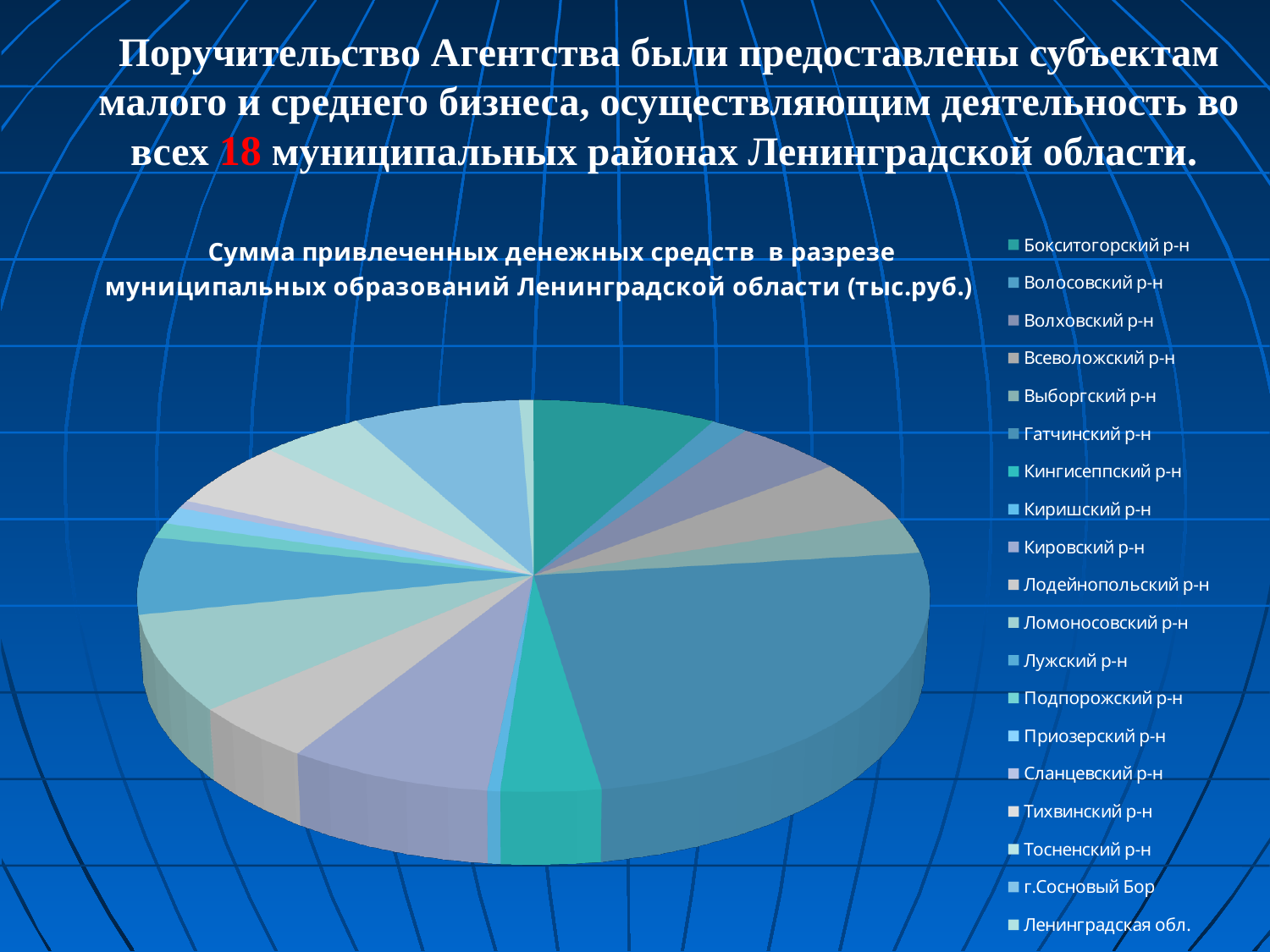
Which category has the largest slice in the pie chart? Гатчинский р-н What kind of chart is shown on the slide? pie chart Is the slice for Кингисеппский р-н larger or smaller than the slice for Киришский р-н? larger Is the slice for Выборгский р-н larger or smaller than the slice for Бокситогорский р-н? smaller How many categories does the legend of the pie chart list? 19 In what units are the values of the pie chart expressed, according to its title? тыс.руб. What is the title of the pie chart? Сумма привлеченных денежных средств в разрезе муниципальных образований Ленинградской области (тыс.руб.)